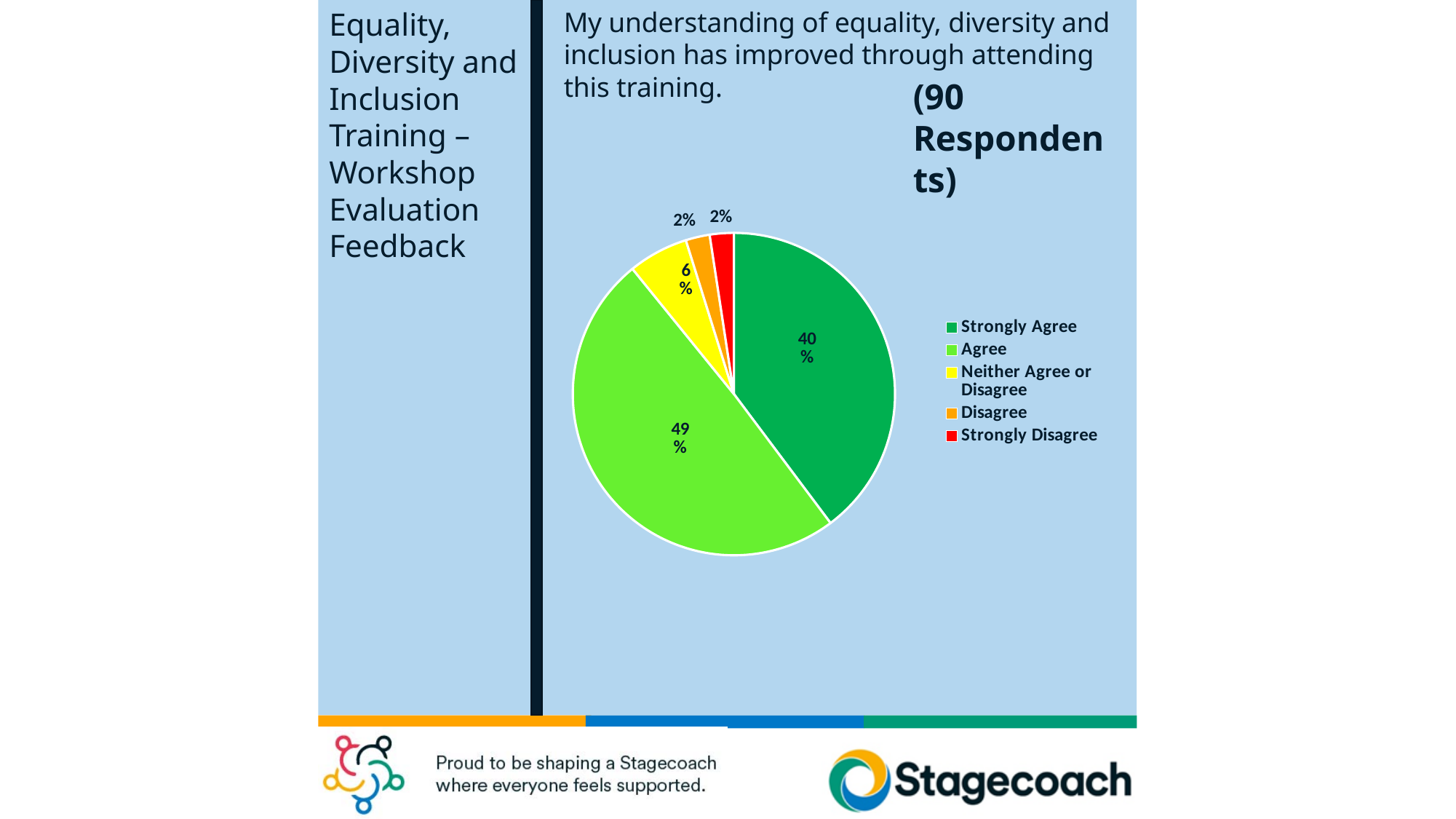
What percentage of respondents selected Agree? 49% What type of chart is shown on the slide? pie chart Which is larger, the share for Strongly Agree or the share for Neither Agree or Disagree? Strongly Agree How many categories does the legend list? 5 What percentage of respondents selected Neither Agree or Disagree? 6% What is the difference in percentage points between Agree and Strongly Agree? 9 What percentage of respondents selected Disagree? 2% What colour is the Strongly Disagree slice in the pie chart? red What percentage of respondents selected Strongly Disagree? 2% Which response category has the largest share of the pie? Agree What percentage of respondents selected Strongly Agree? 40% How many respondents does the slide say took part in the survey? 90